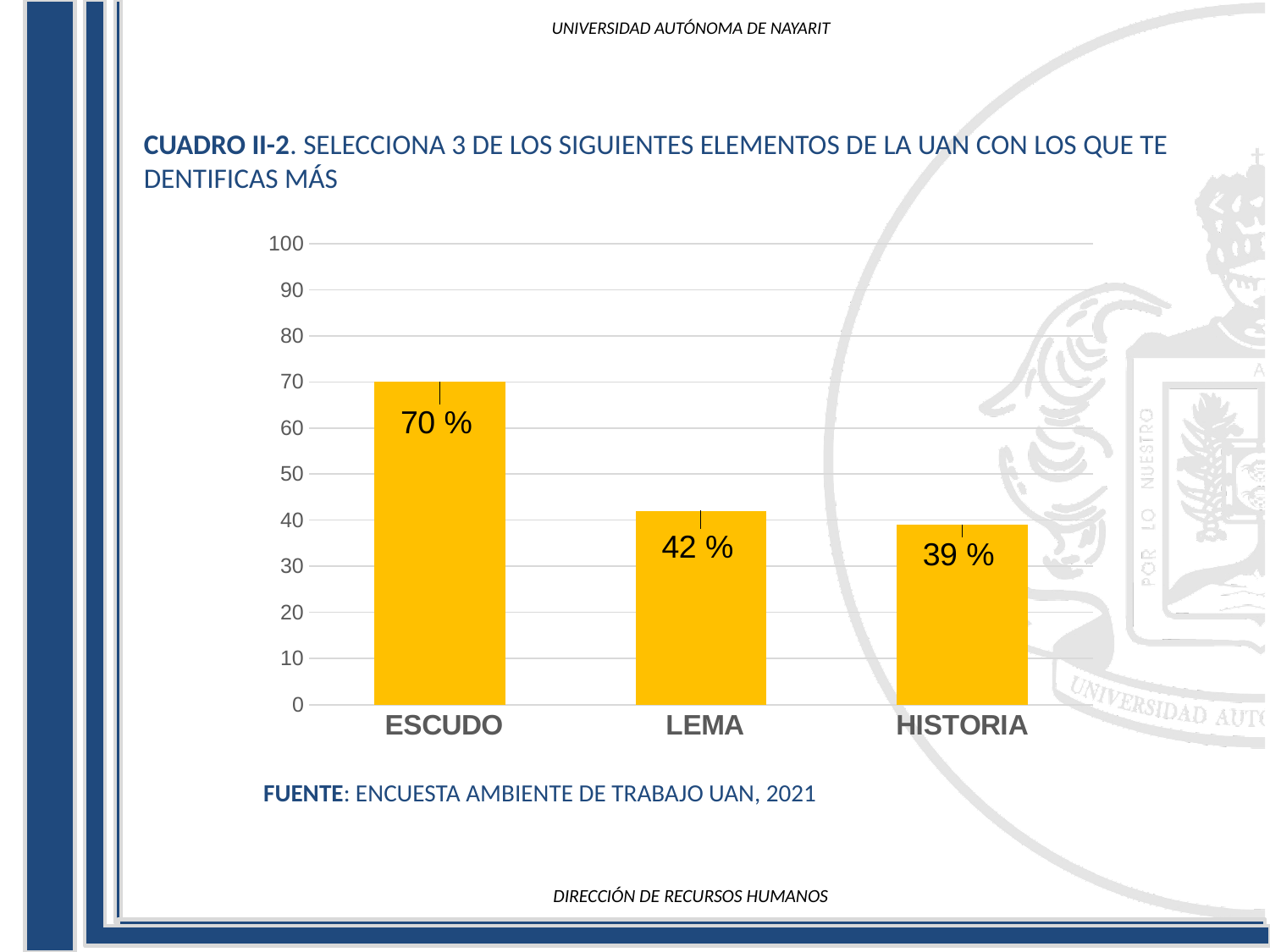
What is the difference between the values for LEMA and HISTORIA? 3 % Which is larger, the value for ESCUDO or the value for HISTORIA? ESCUDO What is the value for ESCUDO? 70 % What kind of chart is shown on the slide? bar chart Which category has the lowest value? HISTORIA What is the value for HISTORIA? 39 % Which category has the highest value? ESCUDO What is the difference between the values for ESCUDO and LEMA? 28 % Is the value for ESCUDO greater or less than 60? greater What is the value for LEMA? 42 % How many categories are shown on the x axis? 3 Do the values rise or fall from left to right along the x axis? fall